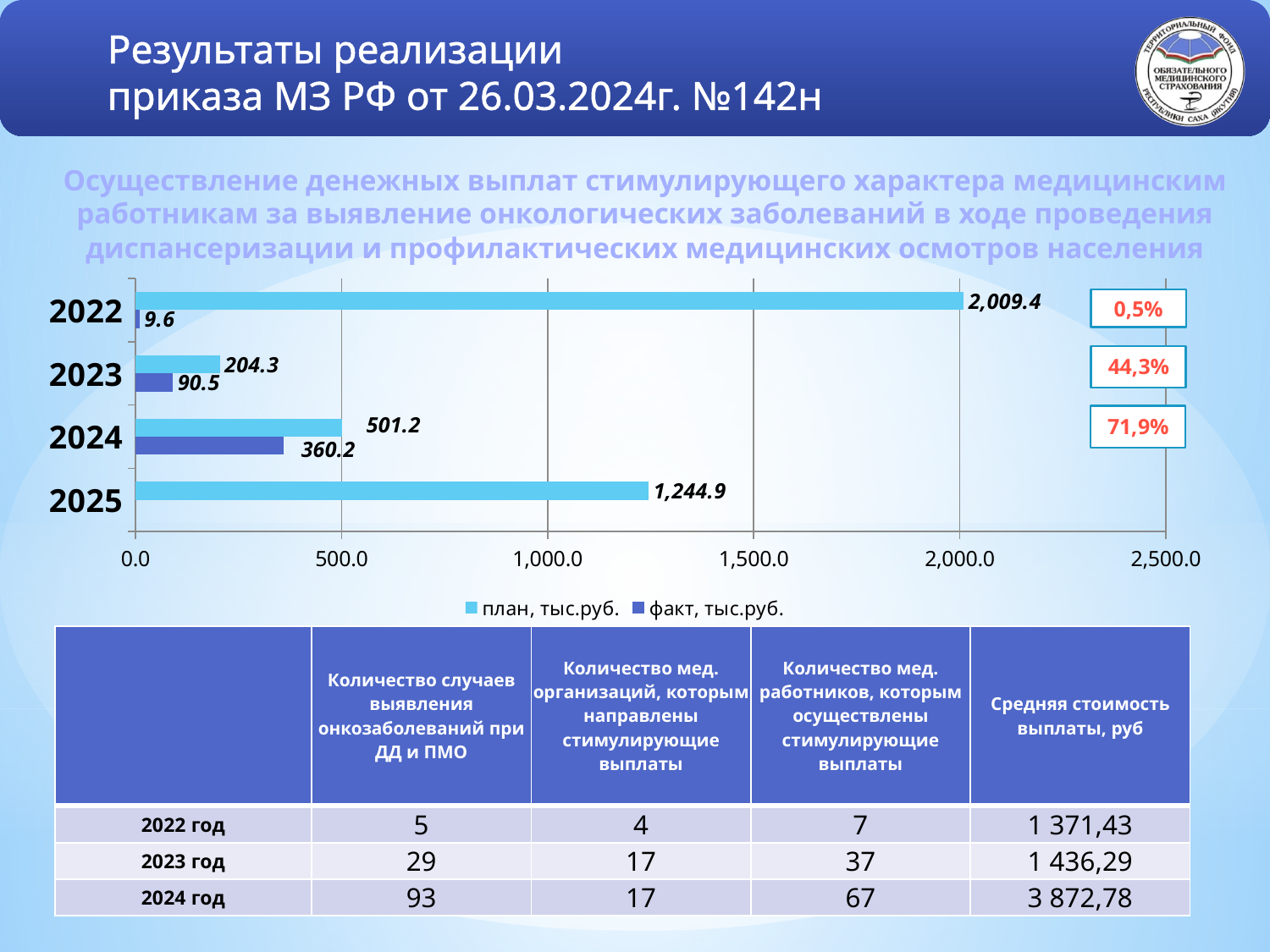
What is the план value for 2025? 1,244.9 How many years are shown on the chart? 4 Is the план value for 2025 greater or less than 1,000.0? greater Which year has the highest план value? 2022 What is the факт value for 2023? 90.5 Which is larger, the план value for 2023 or the факт value for 2024? факт value for 2024 What kind of chart is shown on the slide? bar chart What is the план value for 2022? 2,009.4 What is the difference between the план and факт values for 2024? 141.0 How many series does the legend list? 2 Which year has the lowest факт value? 2022 What is the факт value for 2024? 360.2